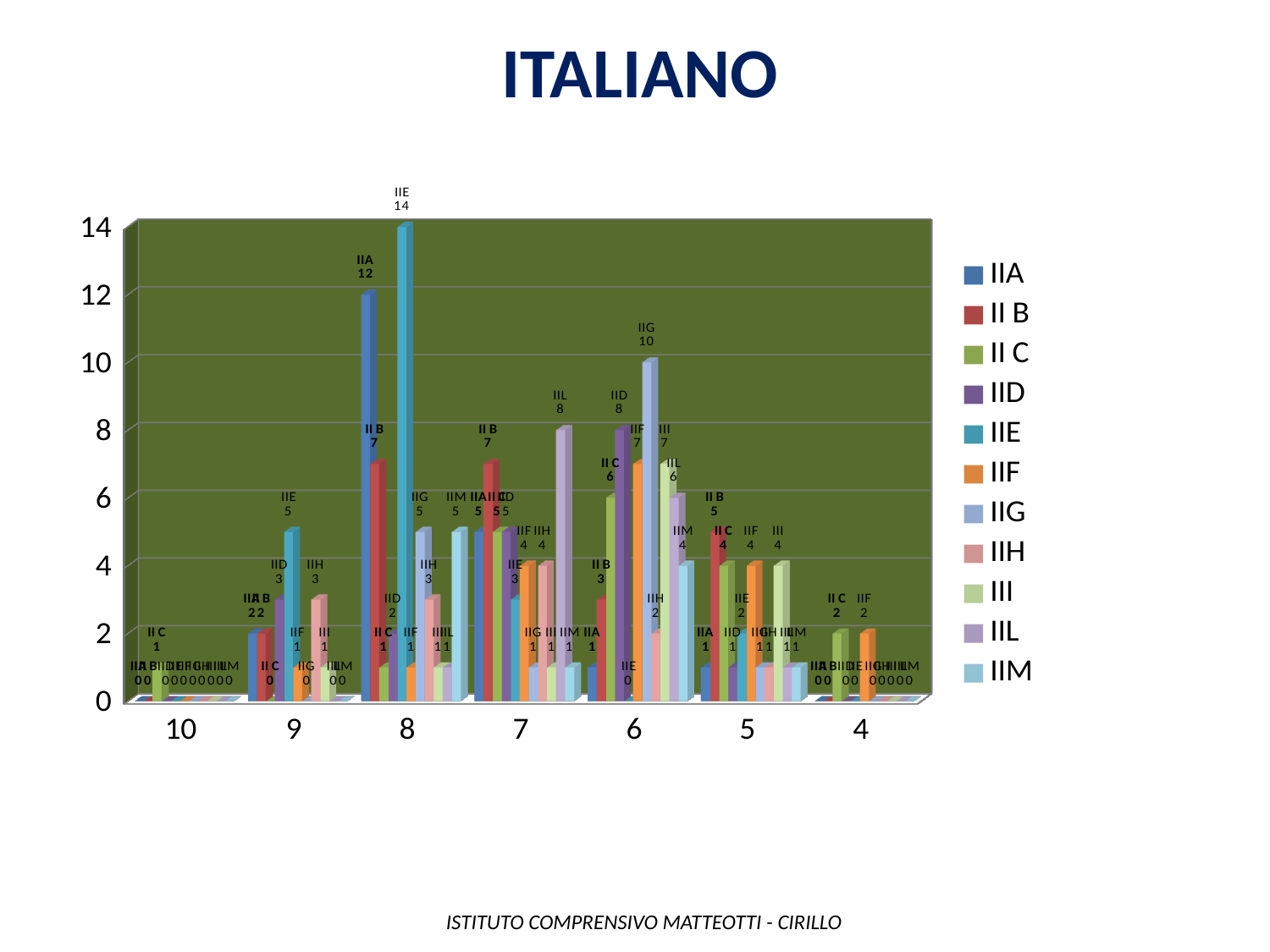
What kind of chart is shown on the slide? bar chart What is the difference between the IIE value and the IIA value in category 8? 2 What is the value for IIE in category 8? 14 What is the value for IIA in category 8? 12 Which series has the highest value in category 8? IIE What is the title of the chart? ITALIANO What is the value for IIL in category 7? 8 How many series does the legend list? 11 Which is larger in category 6: the value for IID or the value for II C? IID What is the value for II B in category 5? 5 What is the value for IIG in category 6? 10 How many categories are shown on the x axis? 7